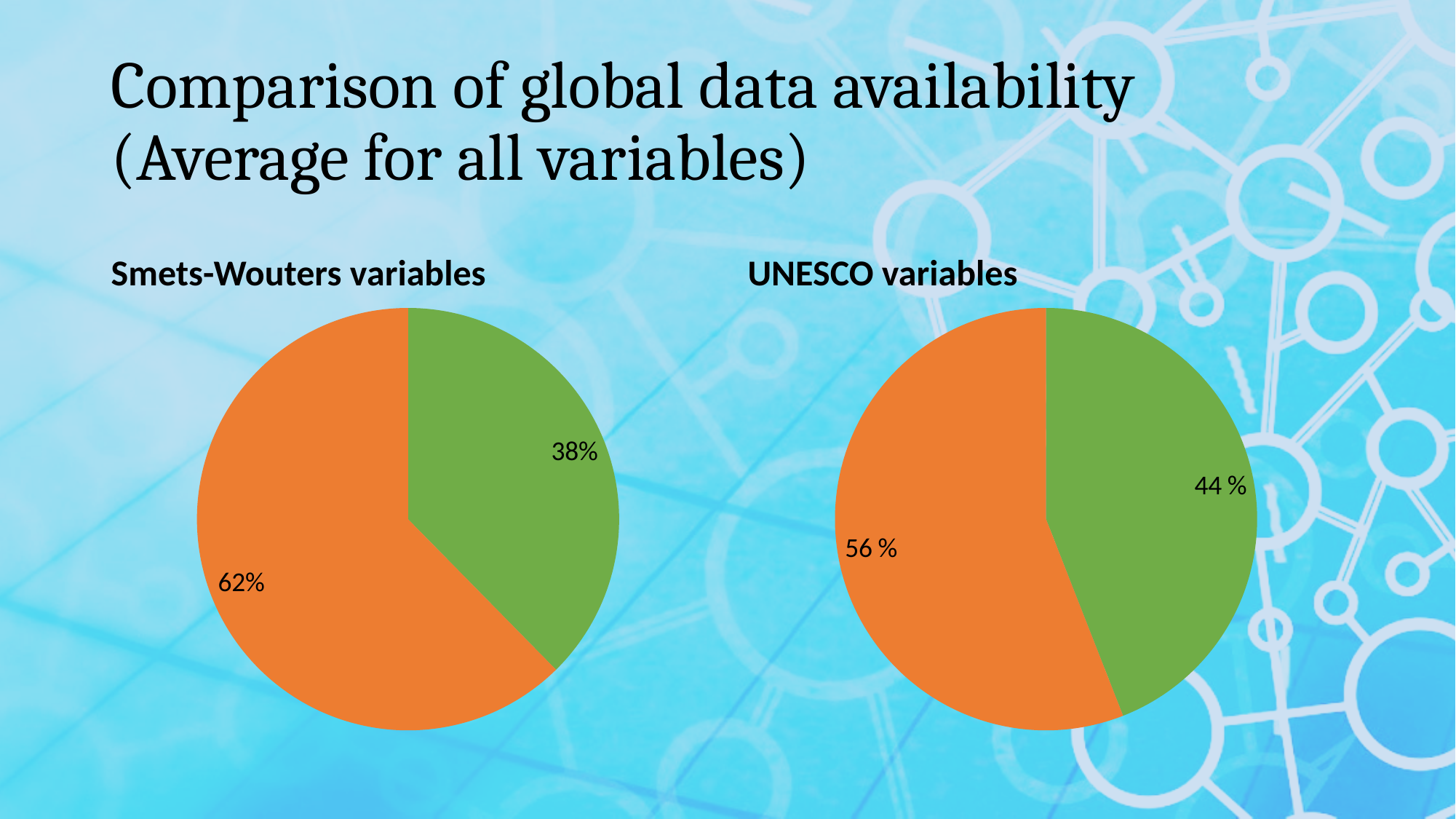
What kind of chart is the 'Smets-Wouters variables' chart? pie chart Which chart has the larger green slice, 'Smets-Wouters variables' or 'UNESCO variables'? UNESCO variables How many slices does the 'UNESCO variables' pie chart have? 2 In the 'Smets-Wouters variables' chart, what share does the orange slice have? 62% In the 'Smets-Wouters variables' chart, which slice is larger, the orange or the green one? orange In the 'UNESCO variables' chart, what share does the orange slice have? 56 % In the 'UNESCO variables' chart, what share does the green slice have? 44 % In the 'Smets-Wouters variables' chart, what is the difference in percentage points between the orange and green slices? 24 How many slices does the 'Smets-Wouters variables' pie chart have? 2 What kind of chart is the 'UNESCO variables' chart? pie chart In the 'UNESCO variables' chart, which slice is the smallest? green